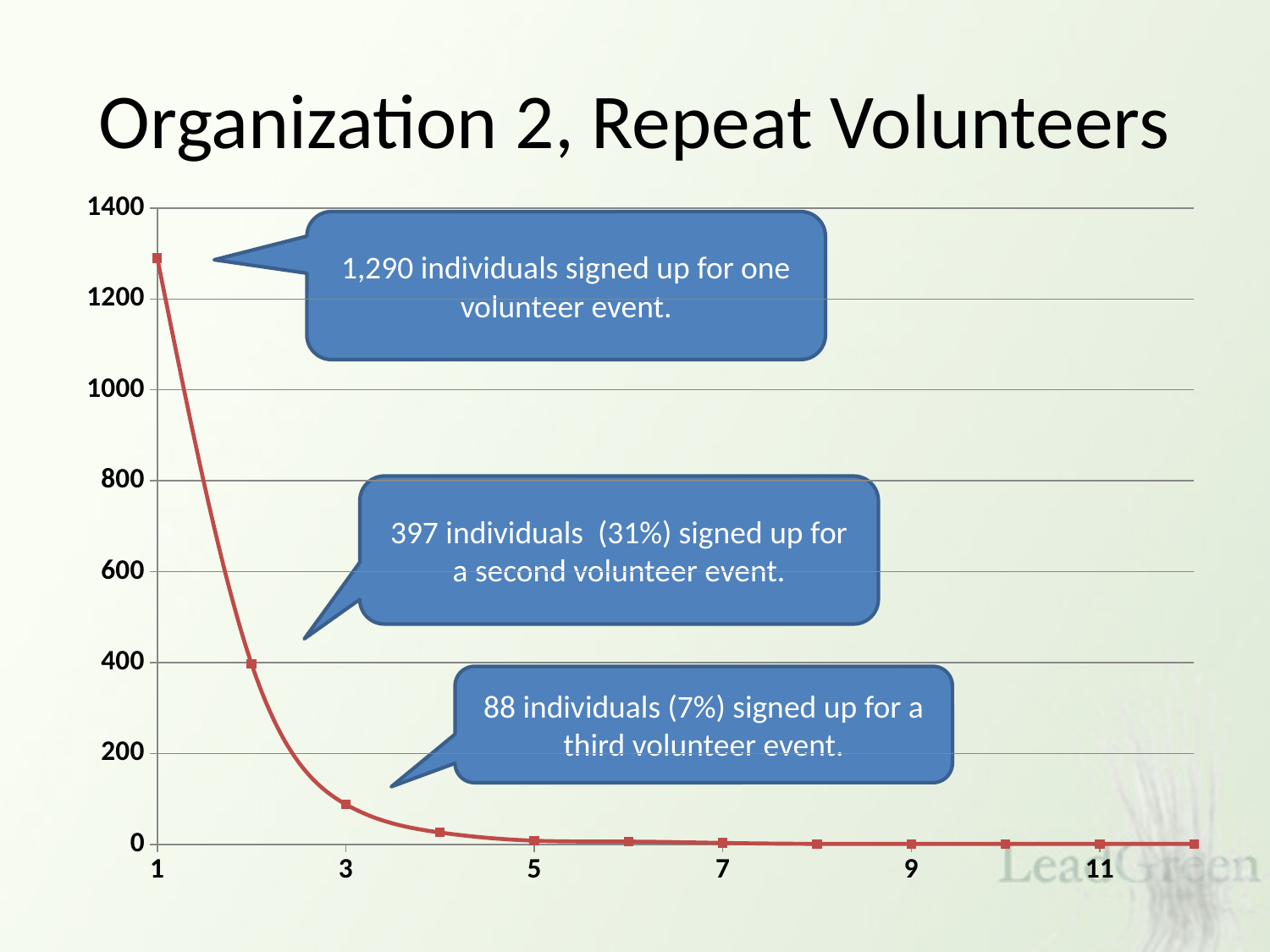
At which x-axis value is the line at its highest? 1 What percentage of individuals signed up for a second volunteer event? 31% What is the difference between the number of individuals who signed up for a second event and those who signed up for a third event? 309 What percentage of individuals signed up for a third volunteer event? 7% How many individuals signed up for one volunteer event (the value at x = 1)? 1,290 What is the title of the chart on the slide? Organization 2, Repeat Volunteers Do the values rise or fall as the x axis increases? fall How many individuals signed up for a second volunteer event (the value at x = 2)? 397 Is the value at x = 4 greater or less than 200? less What kind of chart is shown on the slide? line chart What is the difference between the number of individuals who signed up for one event and those who signed up for a second event? 893 How many individuals signed up for a third volunteer event (the value at x = 3)? 88